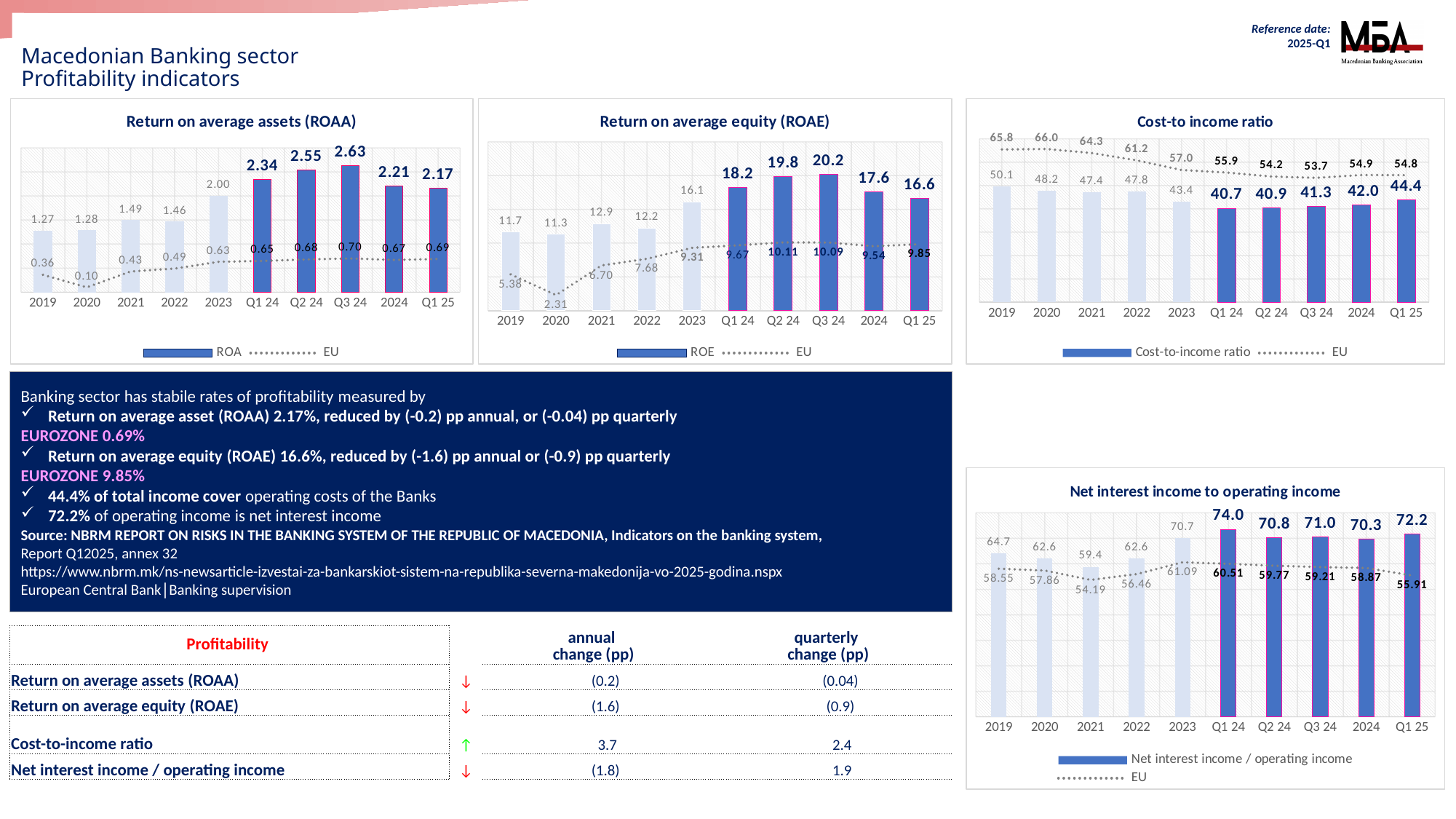
In the 'Return on average assets (ROAA)' chart, what is the EU value for 2020? 0.10 In the 'Return on average equity (ROAE)' chart, what is the ROE value for Q2 24? 19.8 In the 'Cost-to income ratio' chart, is the EU value for Q1 25 larger or smaller than the Cost-to-income ratio value for Q1 25? larger How many periods are shown on the x axis of the 'Net interest income to operating income' chart? 10 In the 'Return on average assets (ROAA)' chart, what is the ROA value for Q1 25? 2.17 In the 'Return on average equity (ROAE)' chart, what is the difference between the ROE value for Q3 24 and the ROE value for Q1 25? 3.6 In the 'Return on average equity (ROAE)' chart, which period has the lowest EU value? 2020 In the 'Cost-to income ratio' chart, what is the Cost-to-income ratio value for 2019? 50.1 In the 'Net interest income to operating income' chart, what is the EU value for Q1 25? 55.91 In the 'Cost-to income ratio' chart, which period has the lowest Cost-to-income ratio bar? Q1 24 In the 'Net interest income to operating income' chart, what is the bar value for Q1 24? 74.0 In the 'Return on average assets (ROAA)' chart, which period has the highest ROA bar? Q3 24